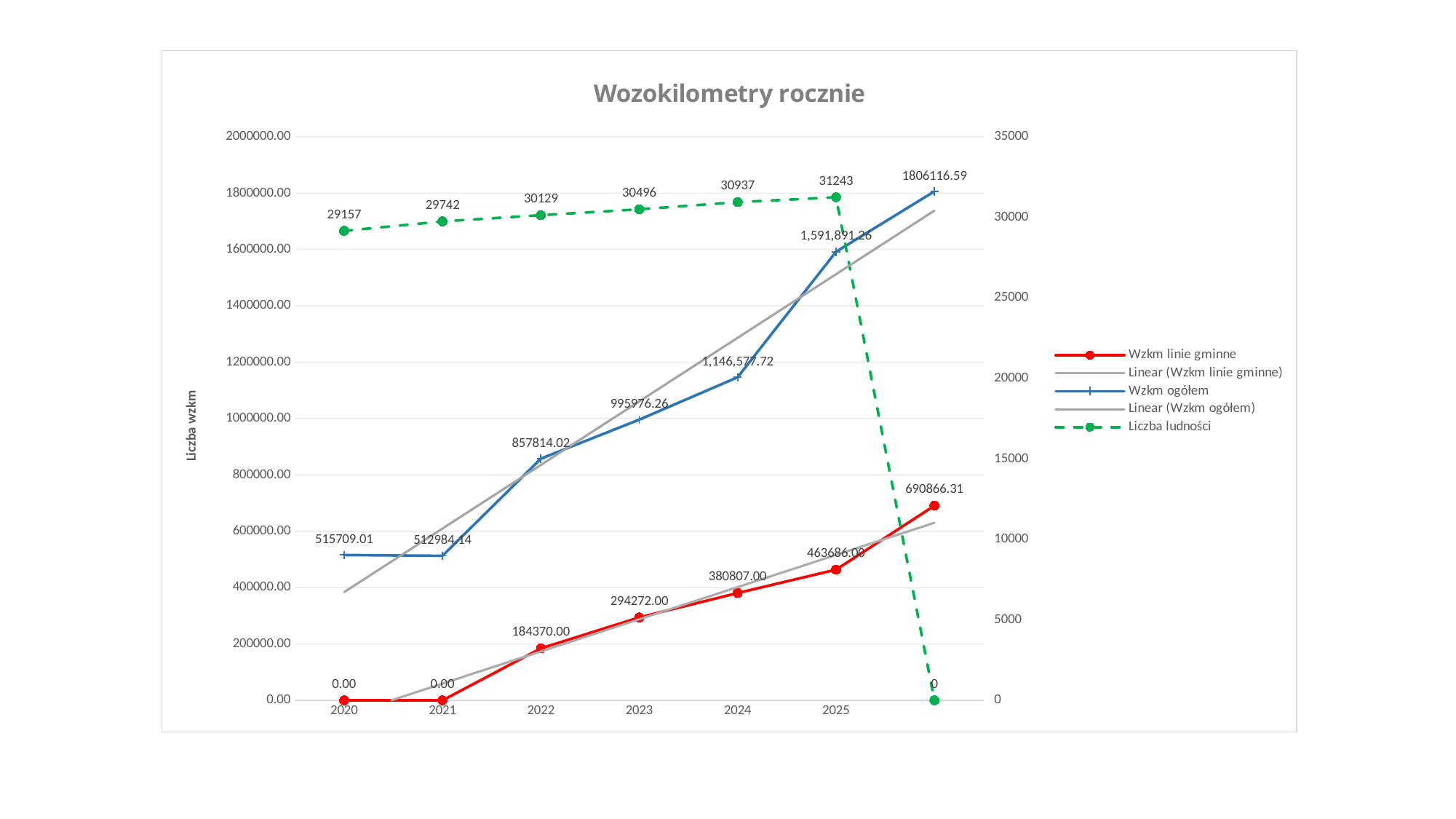
What is the difference between Wzkm linie gminne in 2023 and in 2022? 109902.00 What is the value of Wzkm ogółem in 2023? 995976.26 What is the value of Wzkm linie gminne in 2024? 380807.00 In which year is Wzkm ogółem at its lowest? 2021 Does Wzkm linie gminne rise or fall from 2021 to 2025? rise Which is larger, Wzkm ogółem in 2020 or in 2021? 2020 What is the value of Wzkm ogółem in 2025? 1,591,891.26 What is the title of the chart? Wozokilometry rocznie By how much did Liczba ludności increase from 2020 to 2025? 2086 How many entries does the legend list? 5 What is the value of Liczba ludności in 2022? 30129 What type of chart is shown on the slide? line chart